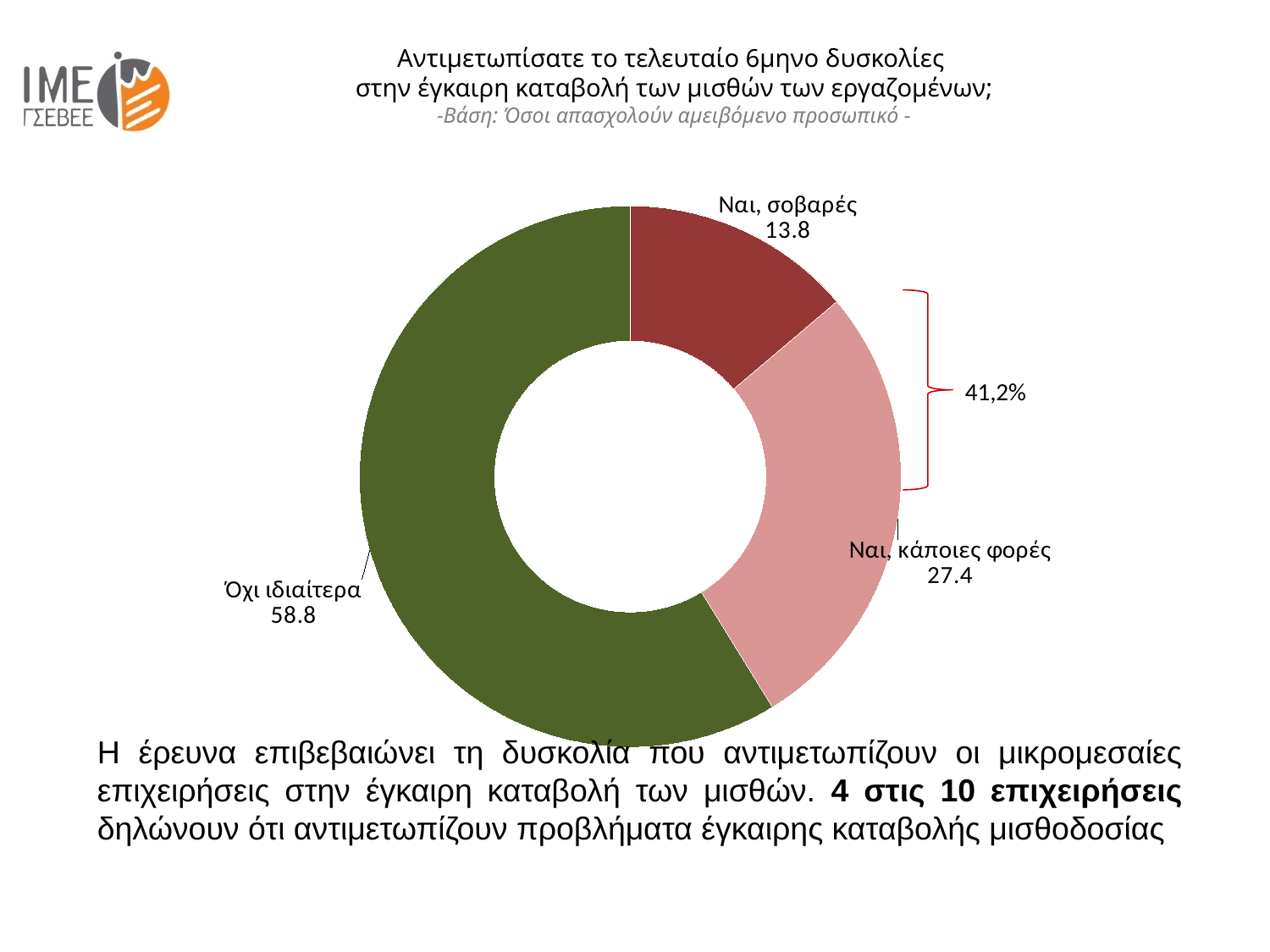
What value is shown for the slice labelled "Ναι, κάποιες φορές"? 27.4 What colour is the slice for "Όχι ιδιαίτερα"? Dark green What value is shown for the slice labelled "Όχι ιδιαίτερα"? 58.8 What value is shown for the slice labelled "Ναι, σοβαρές"? 13.8 Which is larger: the value for "Ναι, κάποιες φορές" or the value for "Ναι, σοβαρές"? Ναι, κάποιες φορές What is the difference between the values for "Ναι, κάποιες φορές" and "Ναι, σοβαρές"? 13.6 What kind of chart is shown on the slide? Doughnut (pie) chart What is the difference between the values for "Όχι ιδιαίτερα" and "Ναι, κάποιες φορές"? 31.4 Which category has the largest slice in the chart? Όχι ιδιαίτερα What percentage is shown next to the bracket grouping the two "Ναι" slices? 41,2% Which category has the smallest slice in the chart? Ναι, σοβαρές How many slices does the chart have? 3